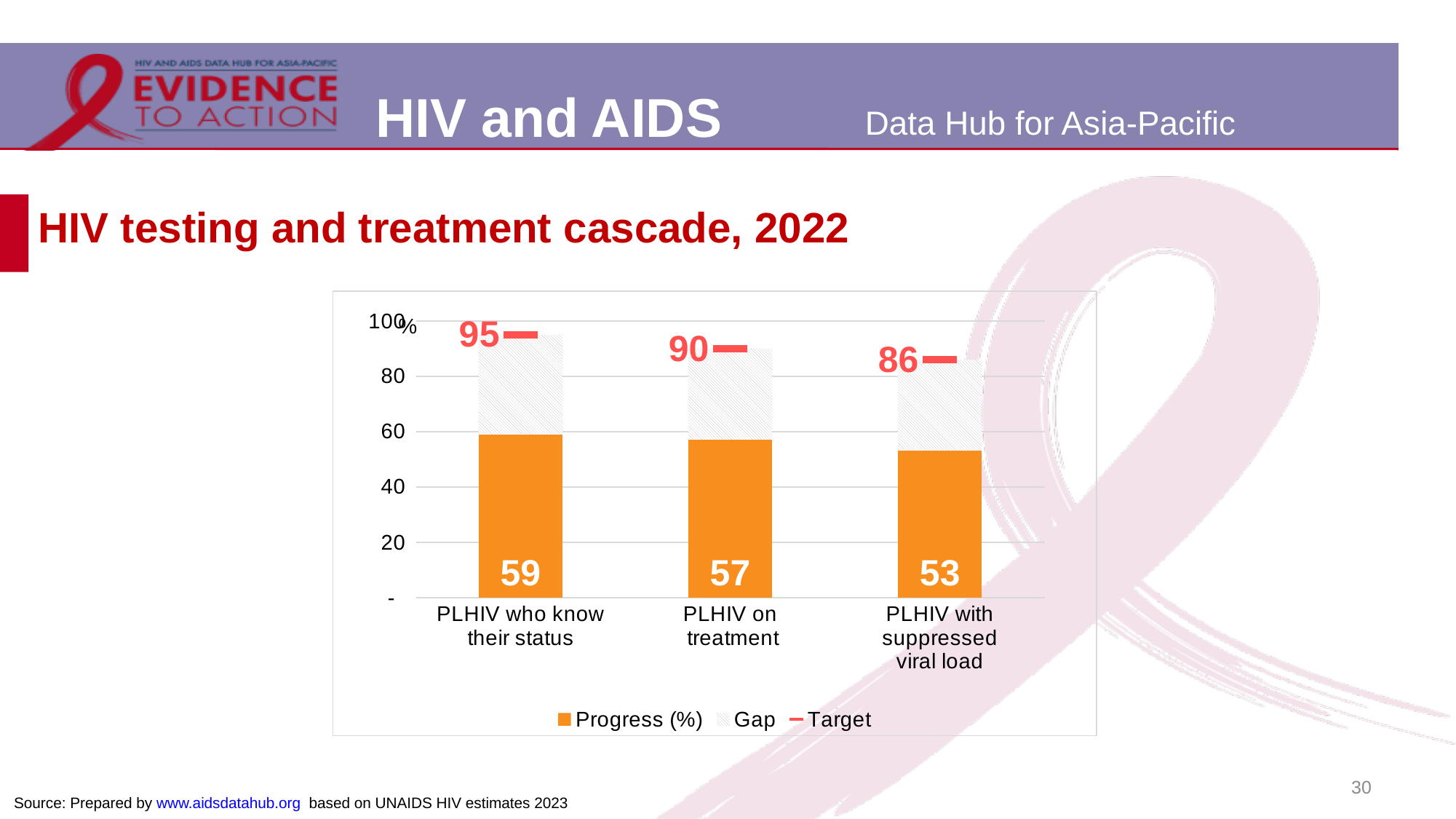
Is the Progress (%) value for PLHIV with suppressed viral load greater or less than 60? less What is the Progress (%) value for PLHIV on treatment? 57 What is the Target value for PLHIV who know their status? 95 Do the Progress (%) values rise or fall from left to right along the x axis? fall How many series does the legend list? 3 What is the Target value for PLHIV with suppressed viral load? 86 What is the difference between the Target and the Progress (%) for PLHIV on treatment? 33 Which category has the highest Progress (%) value? PLHIV who know their status What is the Progress (%) value for PLHIV with suppressed viral load? 53 Which category has the lowest Target value? PLHIV with suppressed viral load What is the Progress (%) value for PLHIV who know their status? 59 How many categories are shown on the x axis? 3